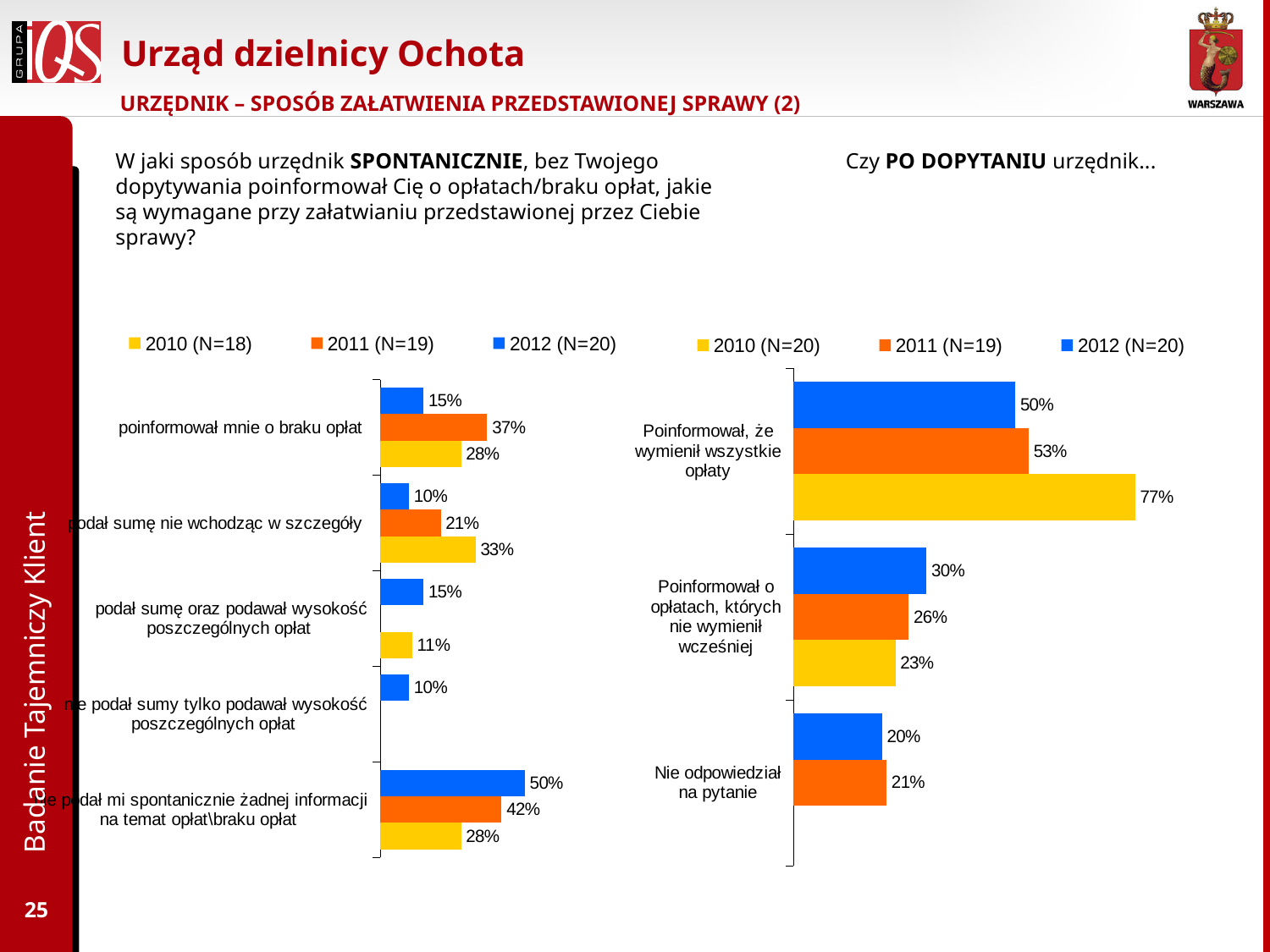
How many categories are shown in the left chart? 5 What type of chart is the right chart? Bar chart In the right chart, which is larger for "Nie odpowiedział na pytanie": the 2011 value or the 2012 value? 2011 (N=19) In the left chart, what is the 2011 value for "poinformował mnie o braku opłat"? 37% In the right chart, which year has the highest value for "Poinformował, że wymienił wszystkie opłaty"? 2010 (N=20) In the right chart, what is the 2010 value for "Poinformował, że wymienił wszystkie opłaty"? 77% In the left chart, what is the difference between the 2012 and 2010 values for "nie podał mi spontanicznie żadnej informacji na temat opłat\braku opłat"? 22% How many series does the legend of the right chart list? 3 In the right chart, what is the 2012 value for "Poinformował o opłatach, których nie wymienił wcześniej"? 30% In the left chart, what sample size is shown in the legend for 2010? N=18 In the left chart, which year has the lowest value for "poinformował mnie o braku opłat"? 2012 (N=20) In the left chart, what is the 2010 value for "podał sumę nie wchodząc w szczegóły"? 33%